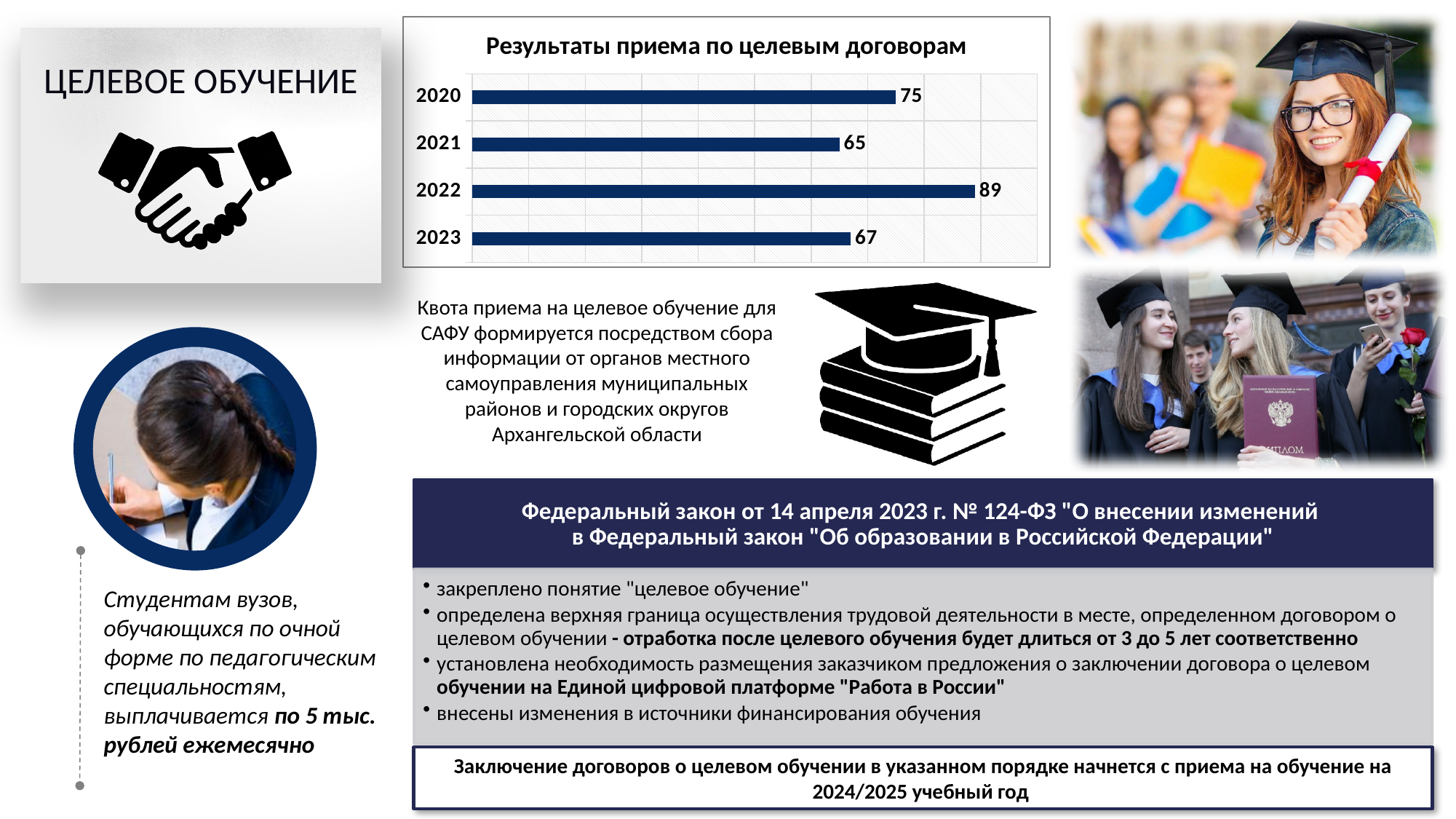
Which year has the lowest value in the chart? 2021 What is the value for 2023 in the chart? 67 What is the value for 2022 in the chart? 89 What is the value for 2021 in the chart? 65 What is the value for 2020 in the chart 'Результаты приема по целевым договорам'? 75 Which year has the highest value in the chart? 2022 How many years are shown in the chart? 4 What is the difference between the values for 2020 and 2023? 8 Which is larger, the value for 2020 or the value for 2023? 2020 What kind of chart is shown on the slide? bar chart What is the title of the chart on the slide? Результаты приема по целевым договорам What is the difference between the values for 2022 and 2021? 24